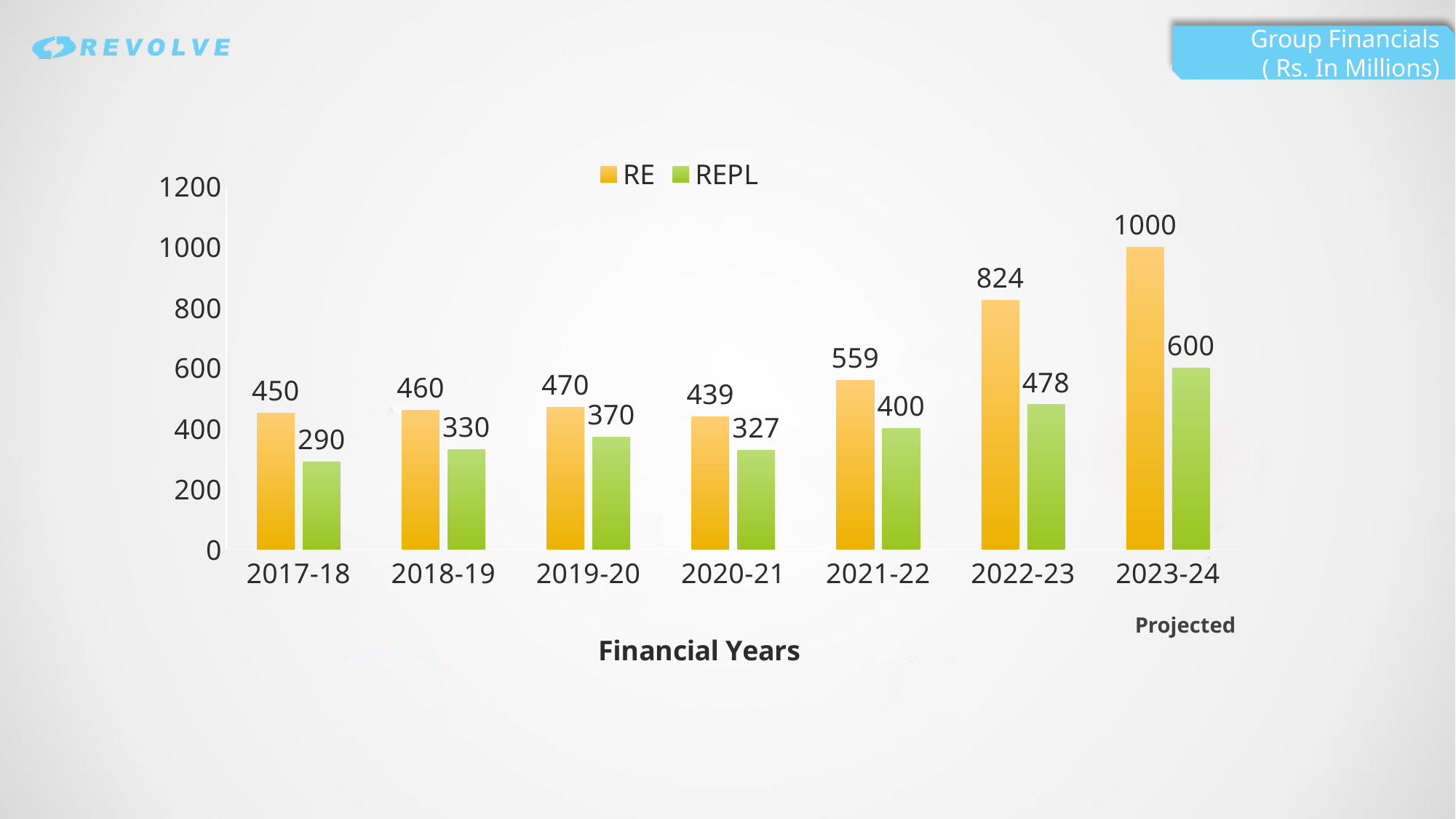
Which is larger, the RE value for 2021-22 or the REPL value for 2023-24? REPL value for 2023-24 What is the difference between the RE and REPL values in 2022-23? 346 Do the REPL values rise or fall from 2020-21 to 2023-24? Rise How many financial years are shown on the x axis? 7 How many series does the legend list? 2 What is the RE value for 2023-24? 1000 What is the REPL value for 2020-21? 327 What is the x axis title of the chart? Financial Years What is the RE value for 2017-18? 450 What kind of chart is shown on the slide? Bar chart Which financial year has the highest REPL value? 2023-24 Which financial year has the lowest RE value? 2020-21